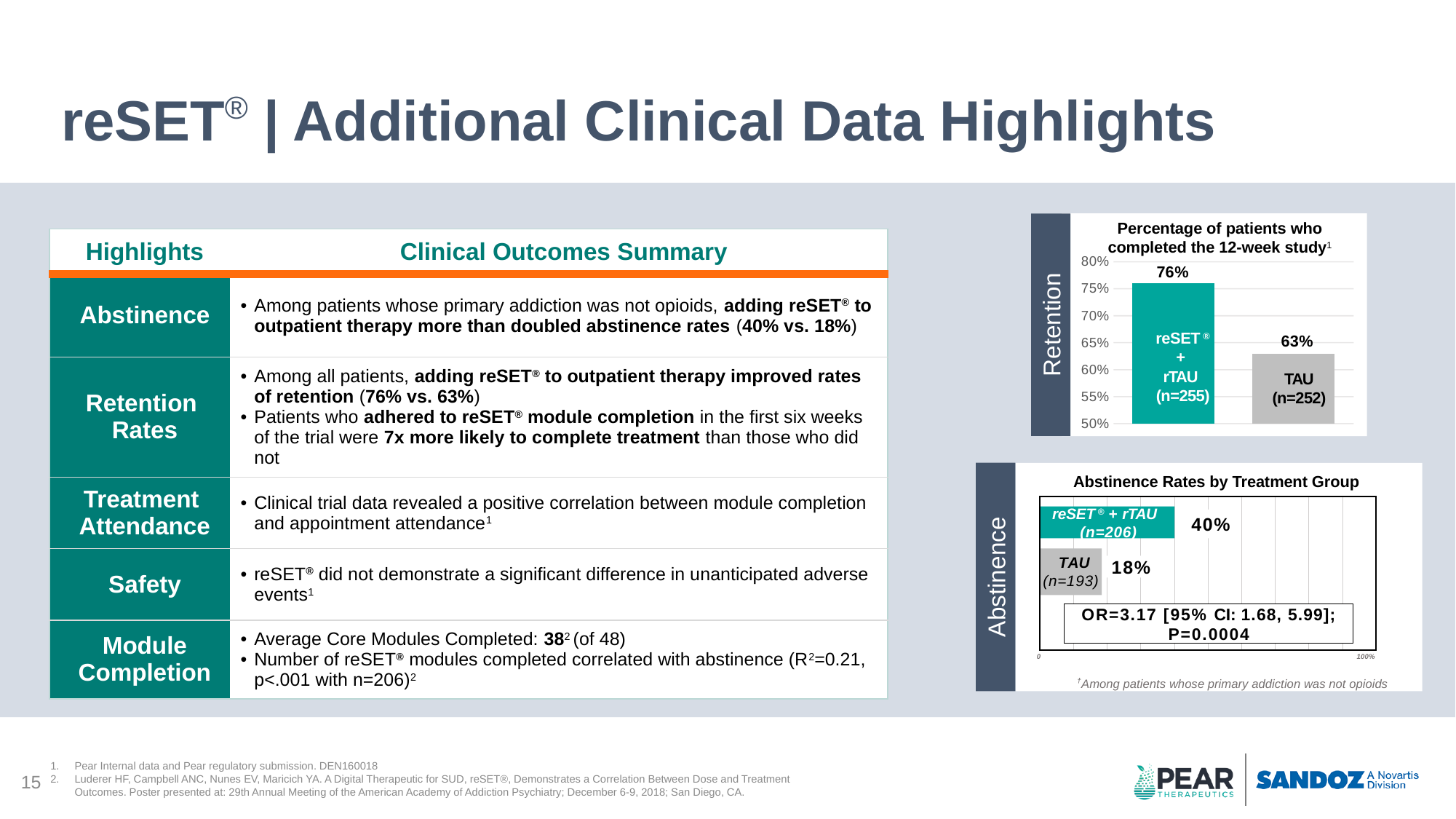
In the 'Abstinence Rates by Treatment Group' chart, what is the abstinence rate for TAU? 18% In the 'Abstinence Rates by Treatment Group' chart, what is the sample size shown for the TAU group? n=193 In the 'Abstinence Rates by Treatment Group' chart, which group has the lower abstinence rate? TAU In the 'Abstinence Rates by Treatment Group' chart, what is the difference between the reSET + rTAU and TAU abstinence rates? 22% In the 'Abstinence Rates by Treatment Group' chart, is the value for TAU greater or less than 20%? less What kind of chart is the 'Percentage of patients who completed the 12-week study' chart? Bar chart In the 'Percentage of patients who completed the 12-week study' chart, which group has the higher completion rate? reSET + rTAU In the 'Percentage of patients who completed the 12-week study' chart, what is the value for reSET + rTAU? 76% In the 'Percentage of patients who completed the 12-week study' chart, how many bars are plotted? 2 In the 'Abstinence Rates by Treatment Group' chart, what is the abstinence rate for reSET + rTAU? 40% In the 'Percentage of patients who completed the 12-week study' chart, what is the difference between the reSET + rTAU and TAU values? 13% In the 'Percentage of patients who completed the 12-week study' chart, what is the value for TAU? 63%